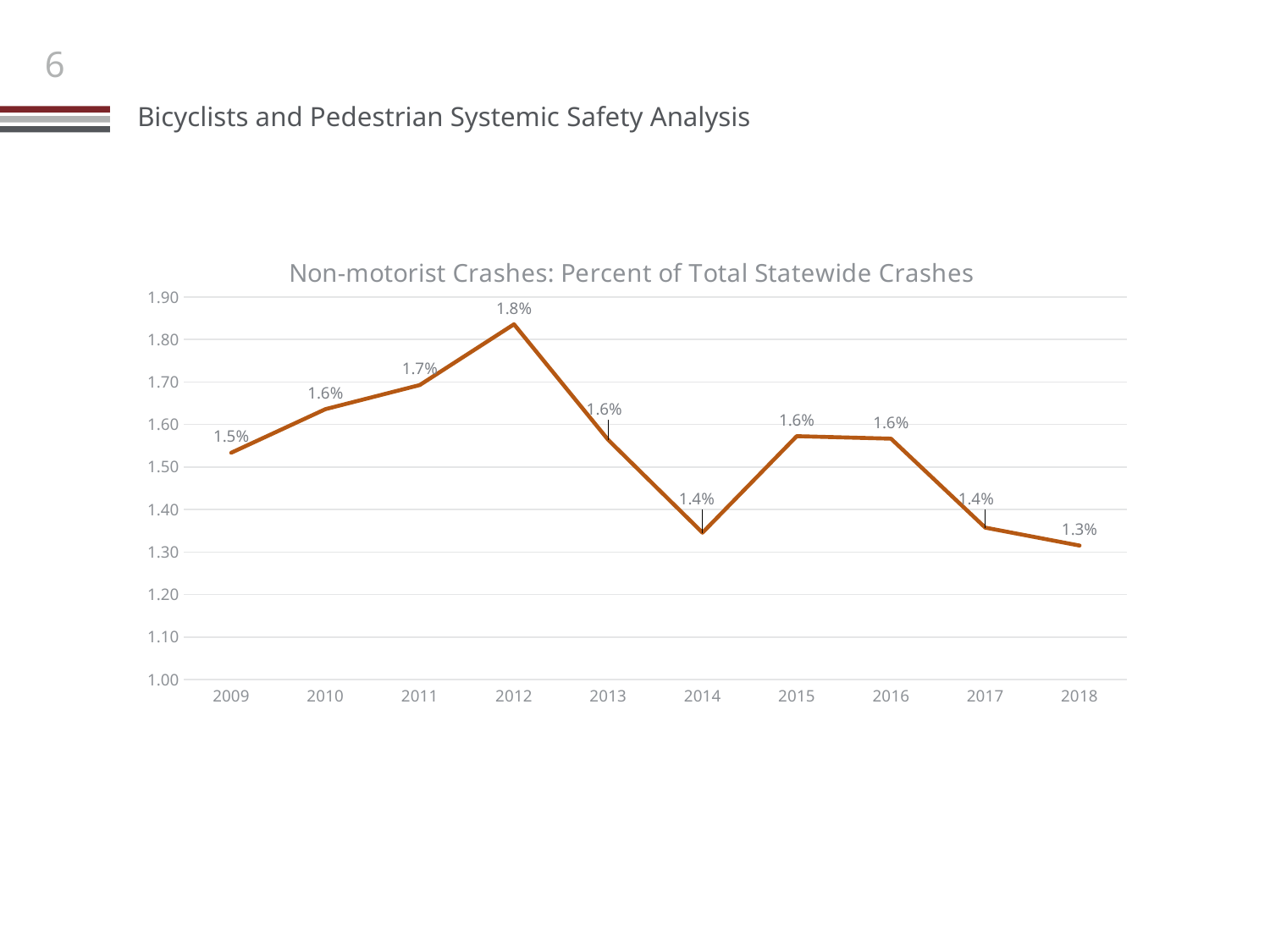
Which is larger, the value for 2012 or the value for 2014? 2012 What is the value for 2012? 1.8% What is the difference between the values for 2012 and 2018? 0.5% Which year has the lowest value? 2018 Do the values rise or fall from 2016 to 2018? fall What is the title of the chart? Non-motorist Crashes: Percent of Total Statewide Crashes Which year has the highest value? 2012 What is the value for 2009? 1.5% Is the value for 2014 greater or less than 1.40? less What is the value for 2018? 1.3% What type of chart is shown on the slide? Line chart How many years are plotted on the chart? 10